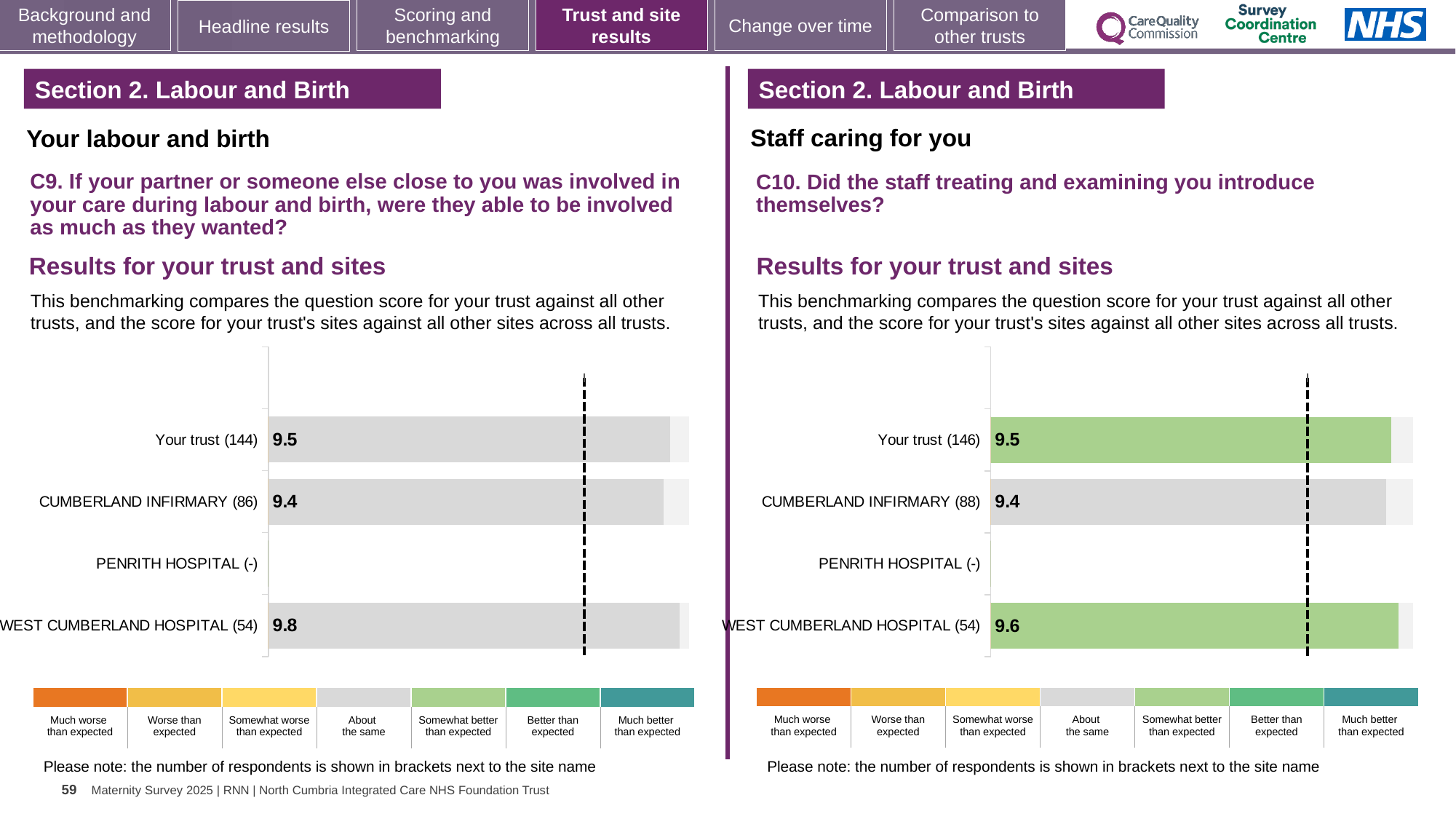
On the right chart (C10), which site or trust has the lowest plotted score? CUMBERLAND INFIRMARY On the left chart (C9), what is the score for Your trust? 9.5 On the right chart (C10), how many respondents are shown in brackets for CUMBERLAND INFIRMARY? 88 On the right chart (C10), what is the score for WEST CUMBERLAND HOSPITAL? 9.6 On the left chart (C9), how many respondents are shown in brackets for Your trust? 144 On the right chart (C10), which is larger: the score for Your trust or the score for WEST CUMBERLAND HOSPITAL? WEST CUMBERLAND HOSPITAL What kind of chart is used on the right (C10)? Bar chart How many categories (trust and sites) are listed on the left chart (C9)? 4 On the left chart (C9), what is the score for WEST CUMBERLAND HOSPITAL? 9.8 On the left chart (C9), which site or trust has the highest score? WEST CUMBERLAND HOSPITAL On the right chart (C10), what is the score for CUMBERLAND INFIRMARY? 9.4 On the left chart (C9), what is the difference between the scores for WEST CUMBERLAND HOSPITAL and CUMBERLAND INFIRMARY? 0.4